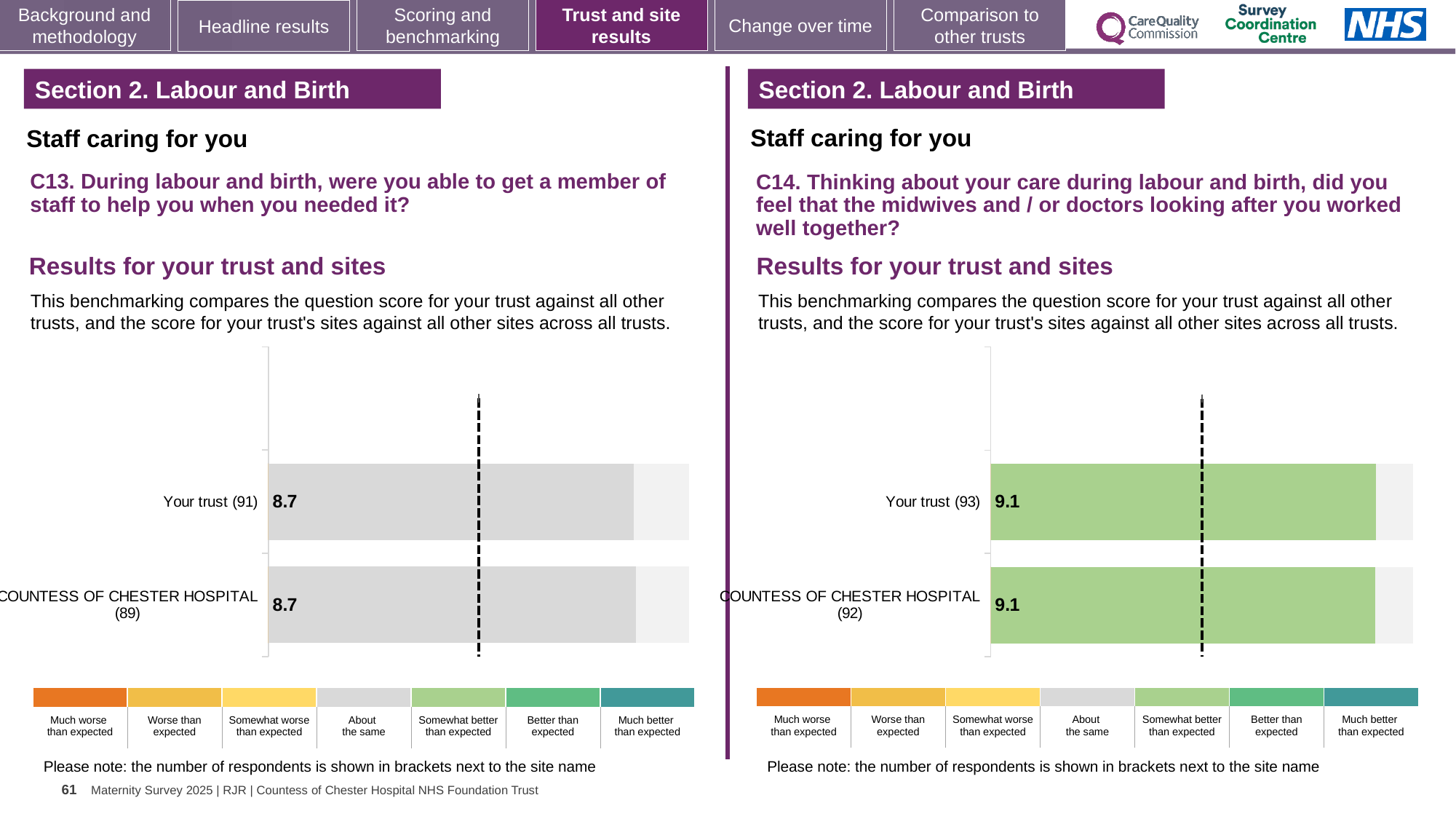
On the C14 chart (right), what is the score for Your trust? 9.1 On the C13 chart (left), what is the score for COUNTESS OF CHESTER HOSPITAL? 8.7 How many bars are plotted on the C13 chart (left)? 2 On the C14 chart (right), how many respondents are shown in brackets for COUNTESS OF CHESTER HOSPITAL? 92 On the C13 chart (left), what is the difference between the Your trust score and the COUNTESS OF CHESTER HOSPITAL score? 0 How many bars are plotted on the C14 chart (right)? 2 On the C14 chart (right), what is the difference between the Your trust score and the COUNTESS OF CHESTER HOSPITAL score? 0 On the C13 chart (left), what is the score for Your trust? 8.7 On the C14 chart (right), what is the score for COUNTESS OF CHESTER HOSPITAL? 9.1 What type of chart is used on the C13 chart (left)? Bar chart Is the Your trust score on the C14 chart (right) larger or smaller than the Your trust score on the C13 chart (left)? Larger On the C13 chart (left), how many respondents are shown in brackets for Your trust? 91